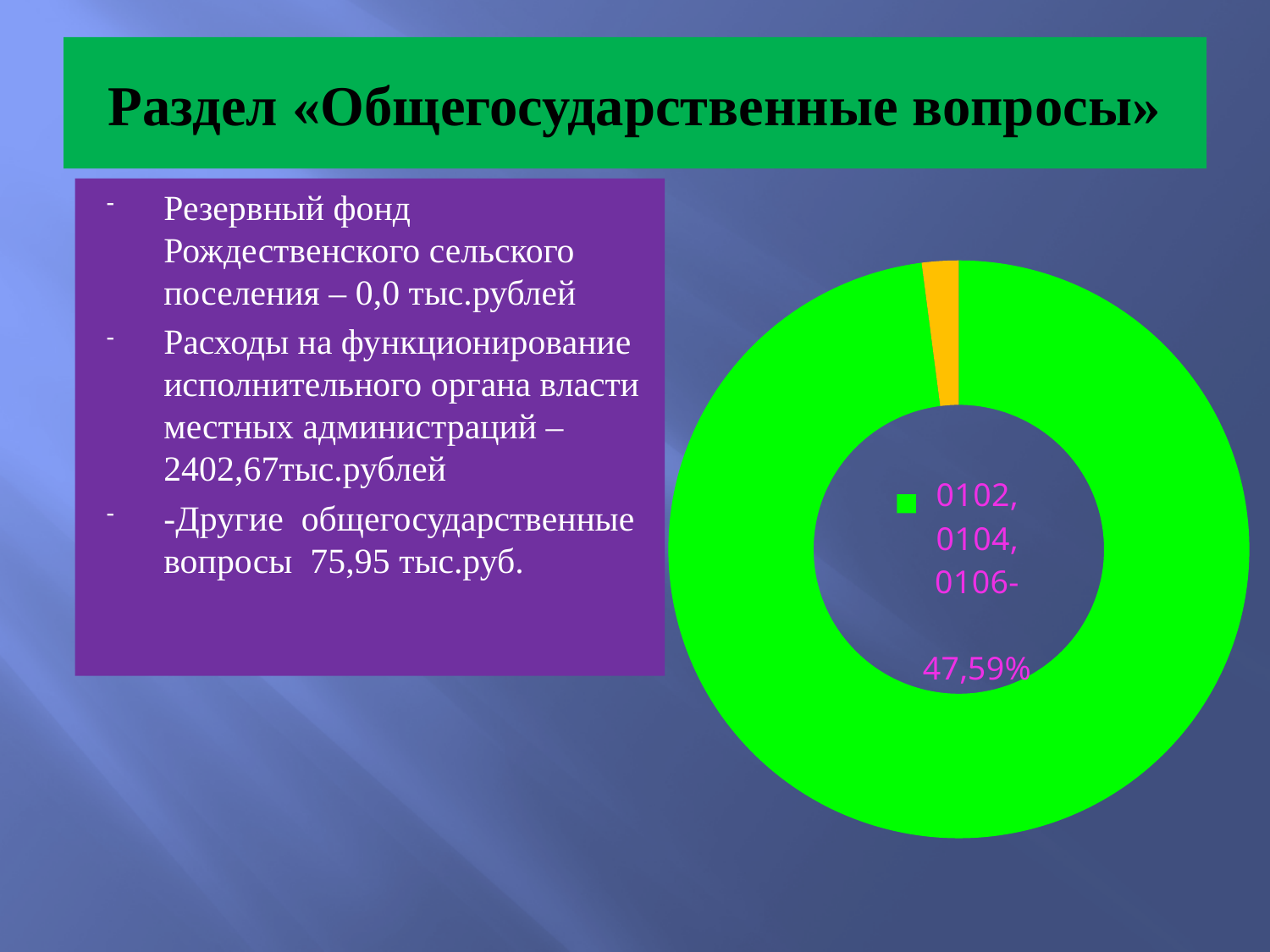
Does the green slice of the doughnut chart take up more or less than half of the ring? More How many slices does the doughnut chart on the slide have? 2 Which slice of the doughnut chart is the smallest? The orange slice Which slice of the doughnut chart is the largest, the green one or the orange one? The green one Is the green slice of the doughnut chart larger or smaller than the orange slice? Larger What kind of chart is shown on the right side of the slide? Doughnut (pie) chart